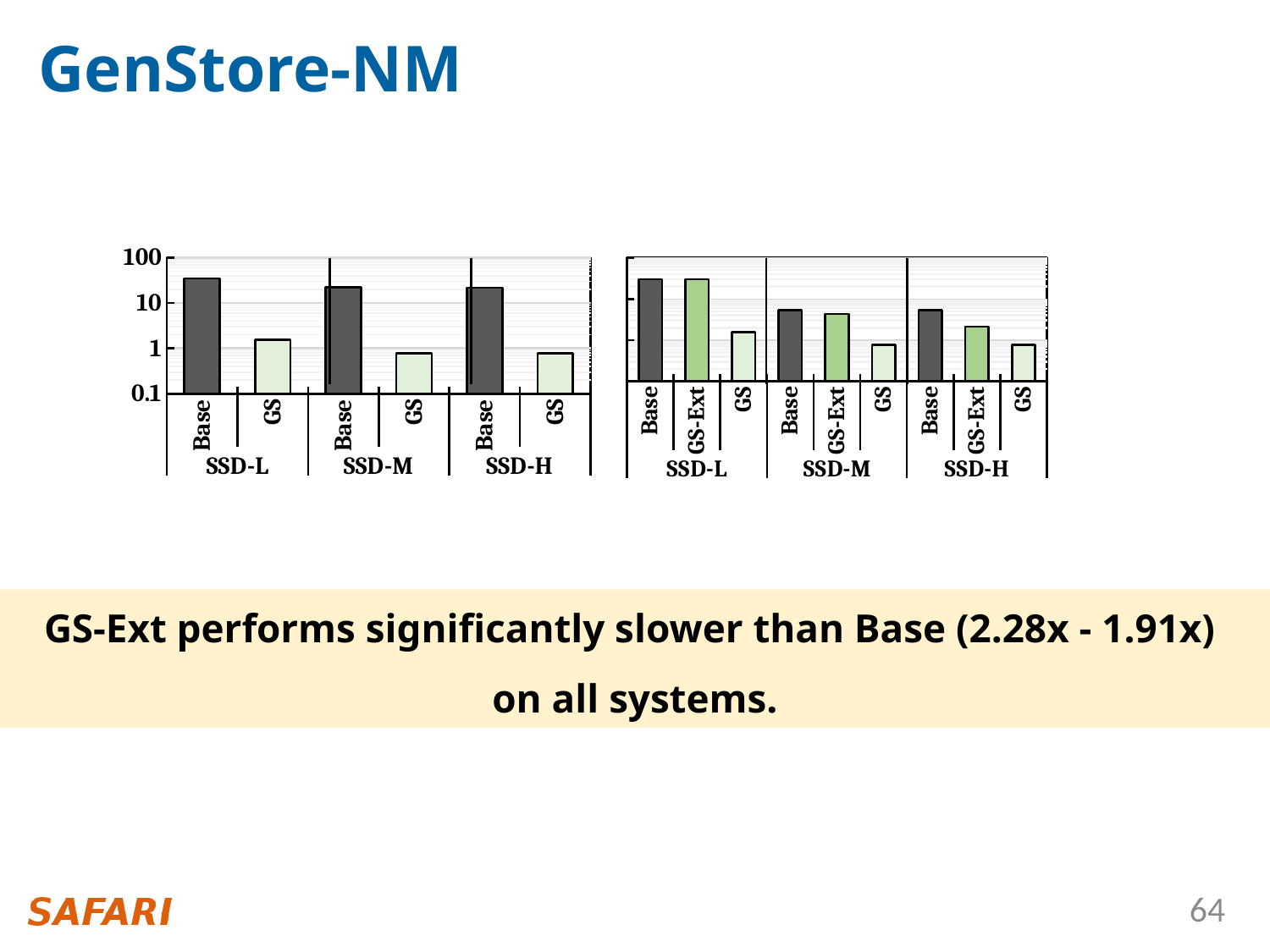
How many bars are shown in each SSD group of the right chart? 3 In the left chart, is the GS value for SSD-L greater or less than 1? greater In the right chart, which bar is the lowest within the SSD-L group? GS In the left chart, which is larger for SSD-M: Base or GS? Base In the left chart, is the Base value for SSD-H greater or less than 10? greater What is the highest tick label on the y-axis of the left chart? 100 In the left chart, which SSD group has the highest Base bar? SSD-L In the left chart, is the GS value for SSD-M greater or less than 1? less How many SSD groups (SSD-L, SSD-M, SSD-H) does the left chart show? 3 In the right chart, which is larger for SSD-M: GS-Ext or GS? GS-Ext What kind of chart is the left chart on the slide? bar chart